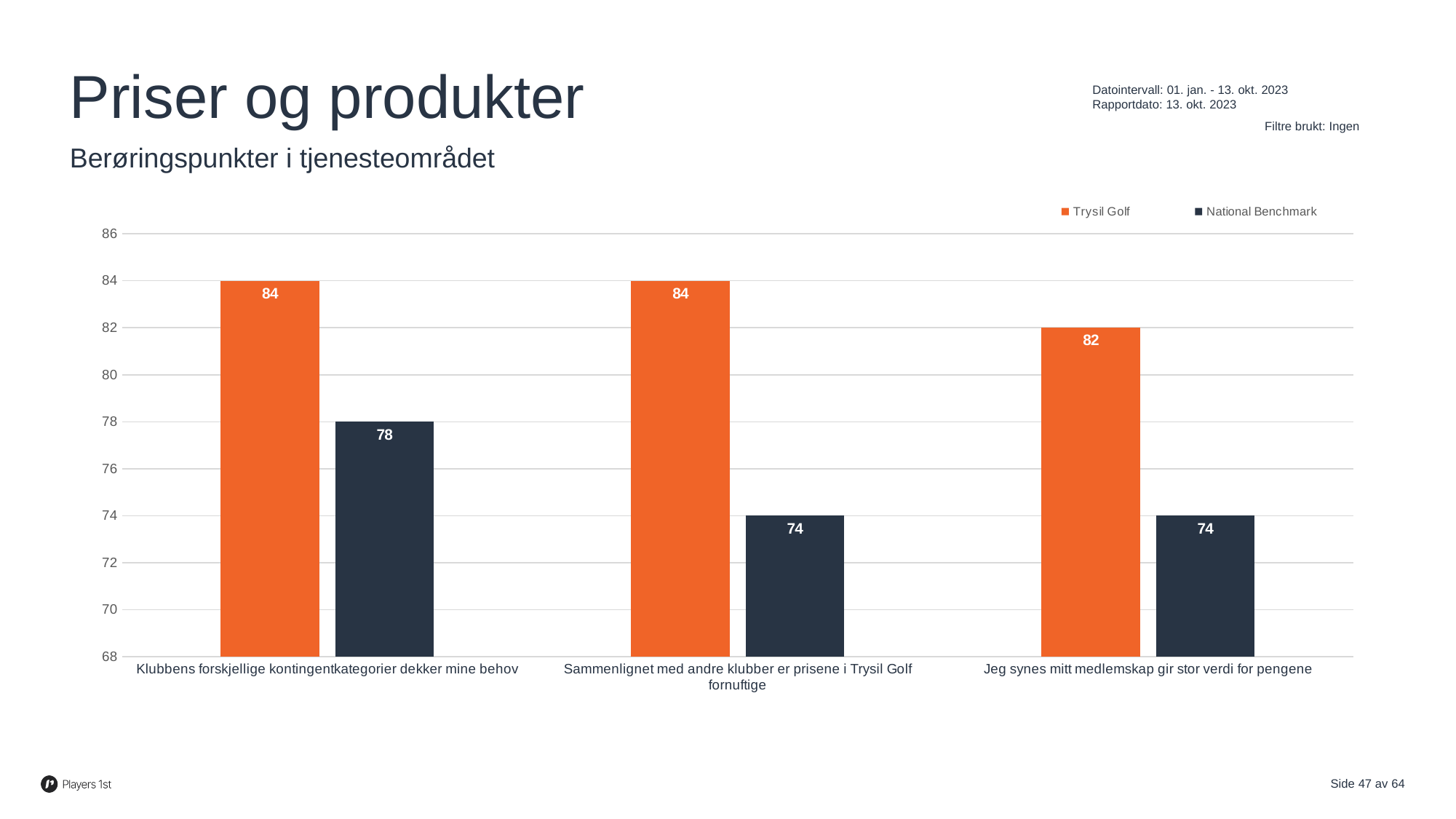
What is the Trysil Golf value for "Jeg synes mitt medlemskap gir stor verdi for pengene"? 82 Which category has the highest National Benchmark value? Klubbens forskjellige kontingentkategorier dekker mine behov What kind of chart is shown on the slide? Bar chart Which category has the lowest Trysil Golf value? Jeg synes mitt medlemskap gir stor verdi for pengene How many series does the legend list? 2 Which colour represents the National Benchmark series? Dark navy What is the difference between the Trysil Golf and National Benchmark values for "Sammenlignet med andre klubber er prisene i Trysil Golf fornuftige"? 10 What is the Trysil Golf value for "Klubbens forskjellige kontingentkategorier dekker mine behov"? 84 How many categories are shown on the x axis? 3 What is the National Benchmark value for "Klubbens forskjellige kontingentkategorier dekker mine behov"? 78 For "Jeg synes mitt medlemskap gir stor verdi for pengene", which is larger: Trysil Golf or National Benchmark? Trysil Golf What is the National Benchmark value for "Sammenlignet med andre klubber er prisene i Trysil Golf fornuftige"? 74